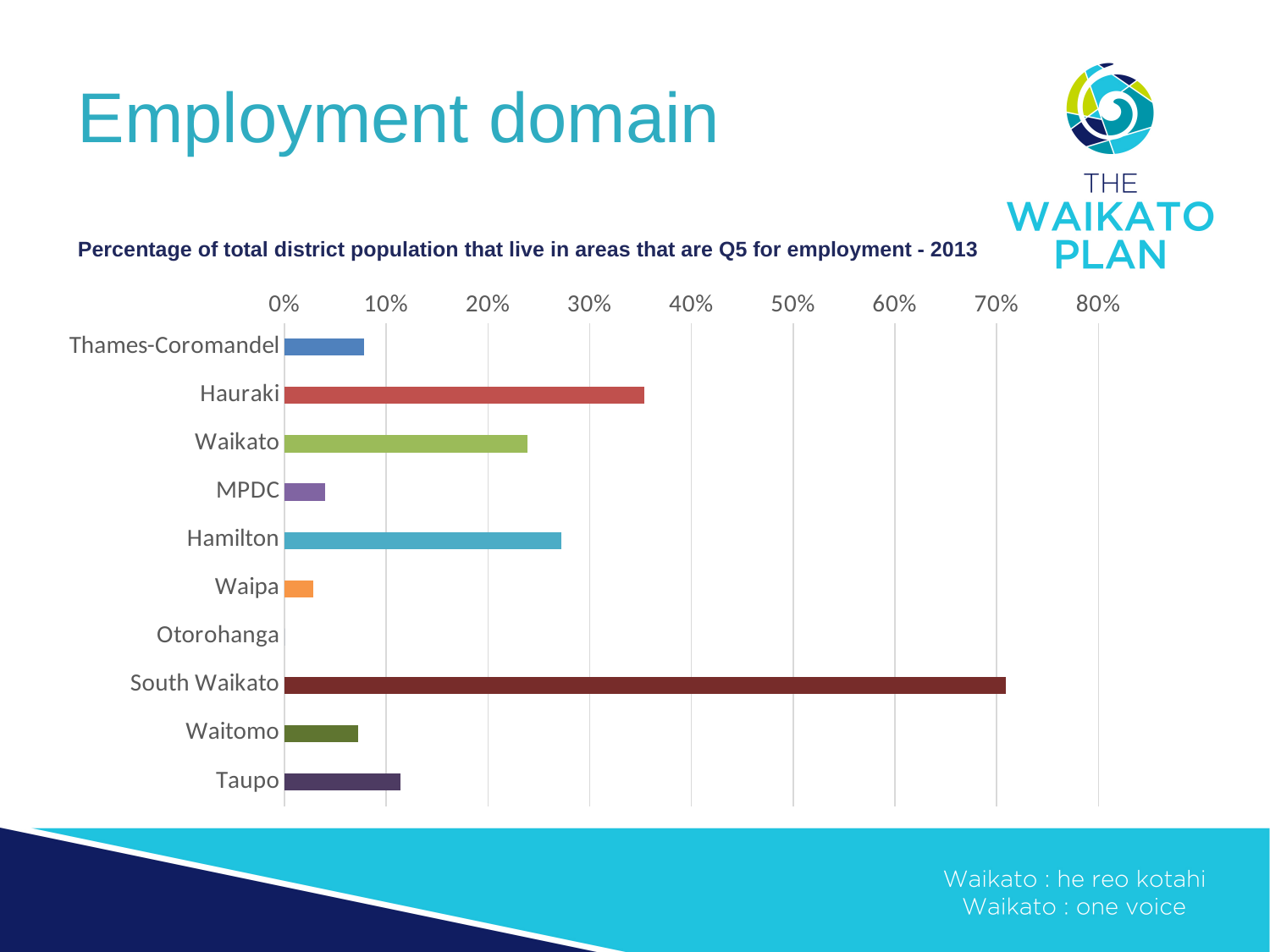
Is the value for South Waikato greater or less than 60%? greater How many districts are plotted on the chart? 10 Is the value for Thames-Coromandel greater or less than 10%? less Which has the larger value, Hauraki or Hamilton? Hauraki What year does the chart title say the data is for? 2013 Is the value for Hauraki greater or less than 30%? greater Which has the larger value, Taupo or Waitomo? Taupo What kind of chart is shown on the slide? Bar chart Which district has the lowest percentage on the chart? Otorohanga Which district has the highest percentage of its population living in areas that are Q5 for employment? South Waikato